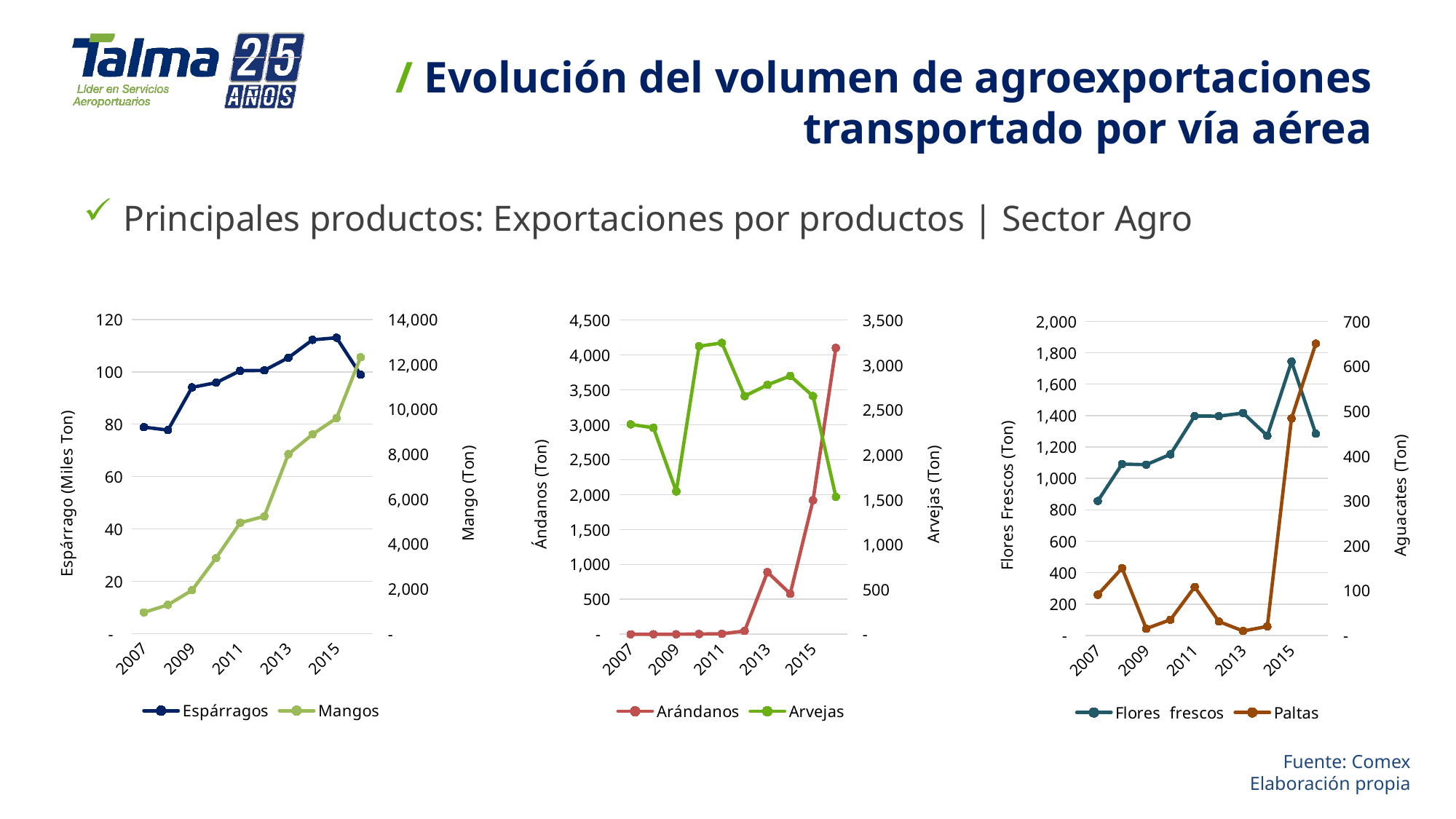
In the left chart, how many data points does the Espárragos series have? 10 In the right chart, which year has the highest Flores frescos value? 2015 In the middle chart, which is larger: the Arándanos value for 2013 or for 2014? 2013 In the middle chart (Arándanos and Arvejas), how many series does the legend list? 2 In the left chart, which year has the highest Mangos value? 2016 What is the label of the right-hand vertical axis of the right chart? Aguacates (Ton) In the middle chart, is the Arándanos value for 2016 greater or less than 4,000? greater What kind of chart is the left chart (Espárragos and Mangos)? line chart In the middle chart, which year has the highest Arándanos value? 2016 In the left chart, is the Mangos value for 2007 greater or less than 2,000? less In the right chart, is the Paltas value for 2016 greater or less than 600? greater In the left chart, do the Mangos values generally rise or fall from 2007 to 2016? rise